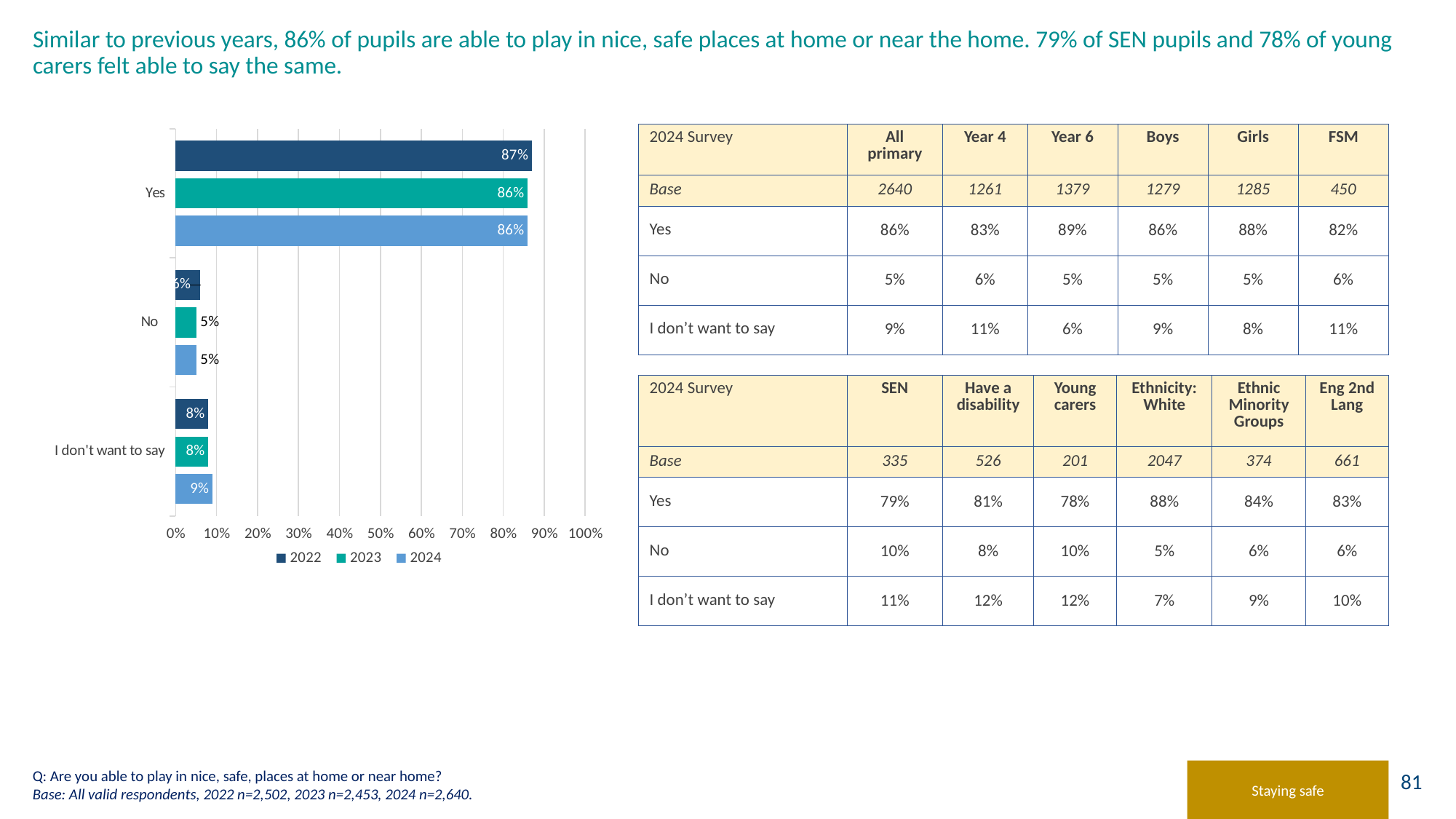
What is the difference between the 'Yes' value in 2022 and the 'Yes' value in 2023 on the chart? 1% Which response category has the lowest value in 2024 on the chart? No On the chart, is the 2024 'I don't want to say' value larger or smaller than the 2024 'No' value? larger How many series does the chart legend list? 3 What is the value for 'Yes' in 2024 on the chart? 86% What kind of chart is shown on the slide? bar chart What is the value for 'No' in 2023 on the chart? 5% Which year does the darkest blue series in the chart legend represent? 2022 How many response categories are shown on the chart? 3 Which response category has the highest value in 2024 on the chart? Yes What is the value for 'Yes' in 2022 on the chart? 87% What is the value for 'I don't want to say' in 2024 on the chart? 9%